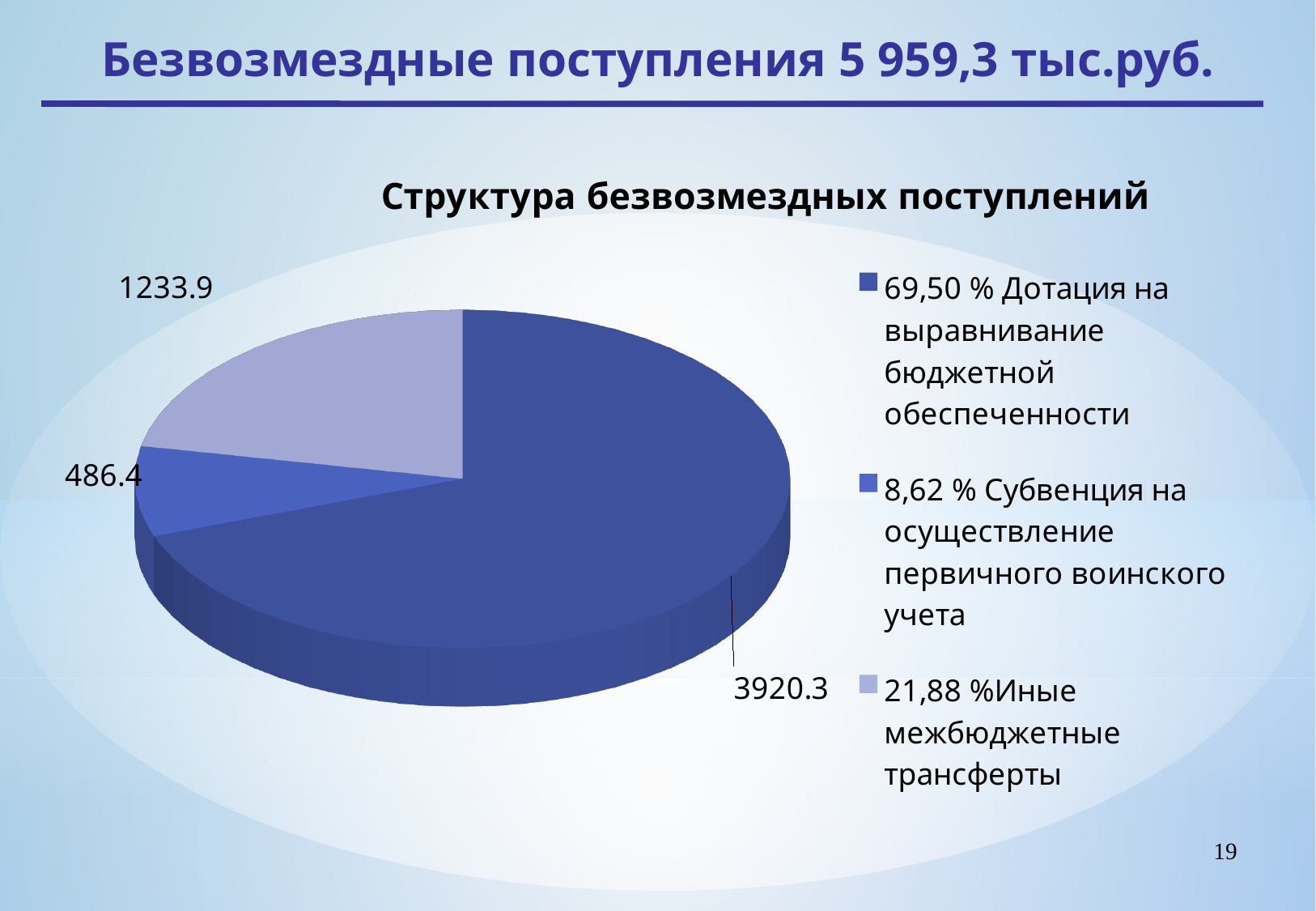
What is the difference between the values for Иные межбюджетные трансферты and Субвенция на осуществление первичного воинского учета? 747.5 What type of chart is shown on the slide? Pie chart What share of the pie does Дотация на выравнивание бюджетной обеспеченности represent, according to the legend? 69,50 % Which category has the largest slice of the pie? Дотация на выравнивание бюджетной обеспеченности What is the value of the slice for Иные межбюджетные трансферты? 1233.9 Which is larger: the slice for Иные межбюджетные трансферты or the slice for Субвенция на осуществление первичного воинского учета? Иные межбюджетные трансферты What is the title of the chart? Структура безвозмездных поступлений Which category has the smallest slice of the pie? Субвенция на осуществление первичного воинского учета What is the value of the slice for Дотация на выравнивание бюджетной обеспеченности? 3920.3 How many slices does the pie chart have? 3 What is the value of the slice for Субвенция на осуществление первичного воинского учета? 486.4 What share of the pie does Иные межбюджетные трансферты represent, according to the legend? 21,88 %